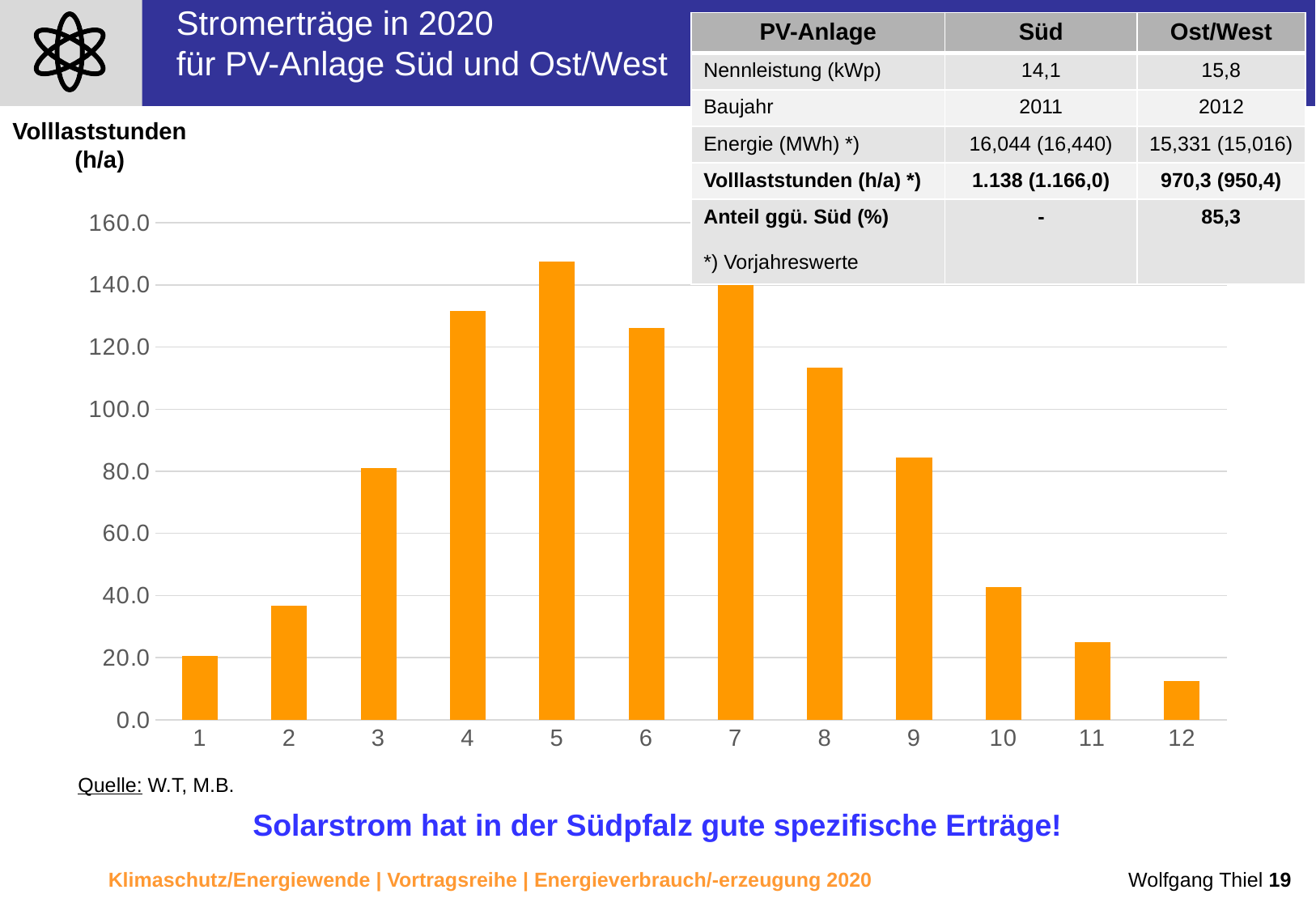
Is the value for month 10 greater or less than 60? less Is the value for month 8 greater or less than 100? greater What kind of chart is shown on the slide? bar chart Which month has the lowest value in the chart? 12 Which has the larger value, month 7 or month 8? 7 Is the value for month 4 greater or less than 120? greater What is the label of the vertical axis of the chart? Volllaststunden (h/a) Do the values rise or fall from month 5 to month 12? fall How many bars (months) are plotted in the chart? 12 Which has the larger value, month 4 or month 8? 4